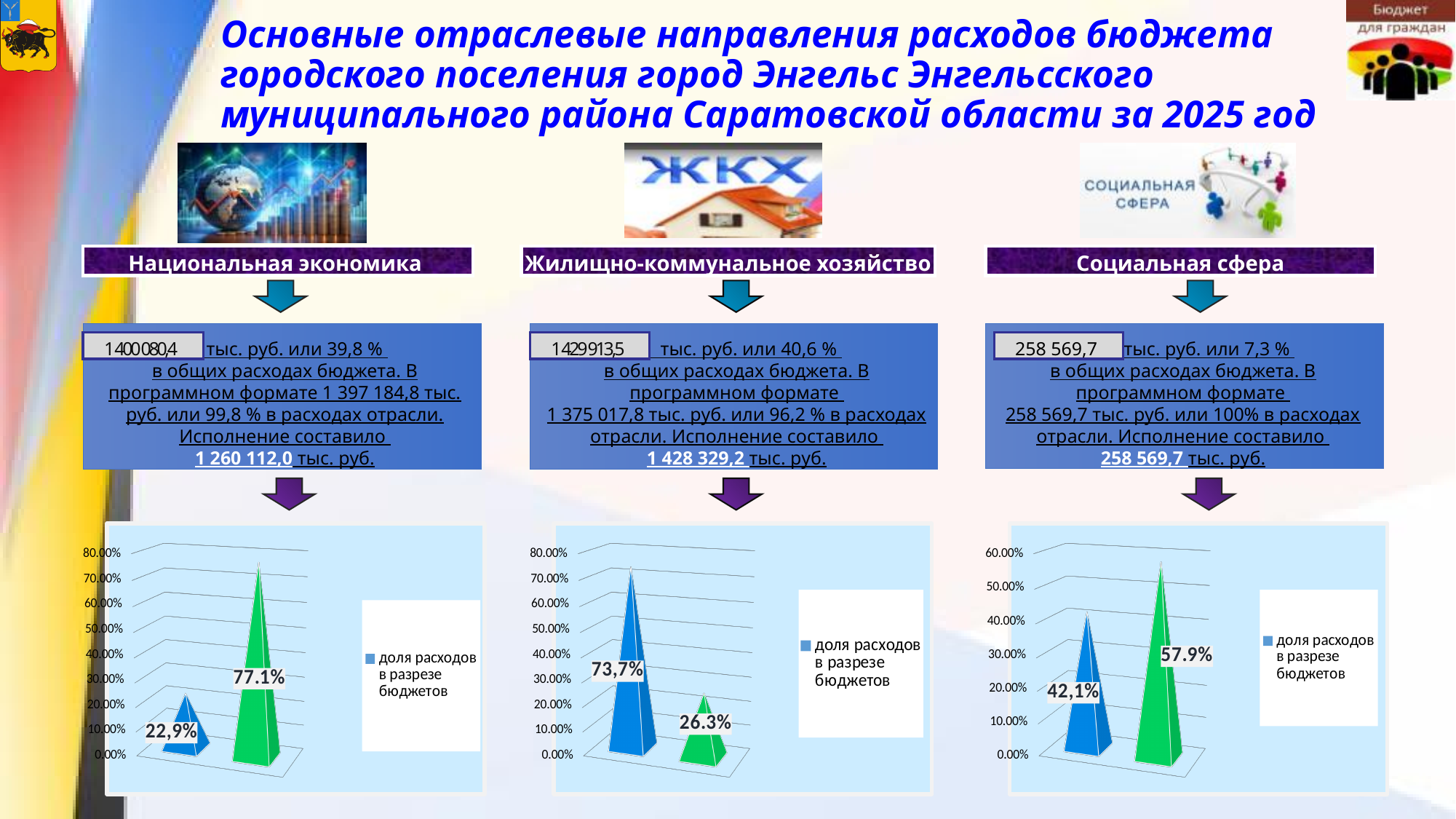
In the chart under "Национальная экономика" (left chart), what value is labelled on the blue bar? 22,9% What kind of chart is shown under "Социальная сфера" (right chart)? bar chart How many bars are plotted in the left chart (Национальная экономика)? 2 In the chart under "Жилищно-коммунальное хозяйство" (middle chart), what value is labelled on the green bar? 26.3% In the chart under "Социальная сфера" (right chart), what value is labelled on the blue bar? 42,1% In the chart under "Национальная экономика" (left chart), what value is labelled on the green bar? 77.1% In the chart under "Социальная сфера" (right chart), what value is labelled on the green bar? 57.9% In the middle chart (Жилищно-коммунальное хозяйство), which bar is larger, the blue one or the green one? blue How many series does the legend of the middle chart (Жилищно-коммунальное хозяйство) list? 1 In the right chart (Социальная сфера), which bar is the highest? the green bar In the left chart (Национальная экономика), what is the difference between the green bar value and the blue bar value? 54.2% In the chart under "Жилищно-коммунальное хозяйство" (middle chart), what value is labelled on the blue bar? 73,7%